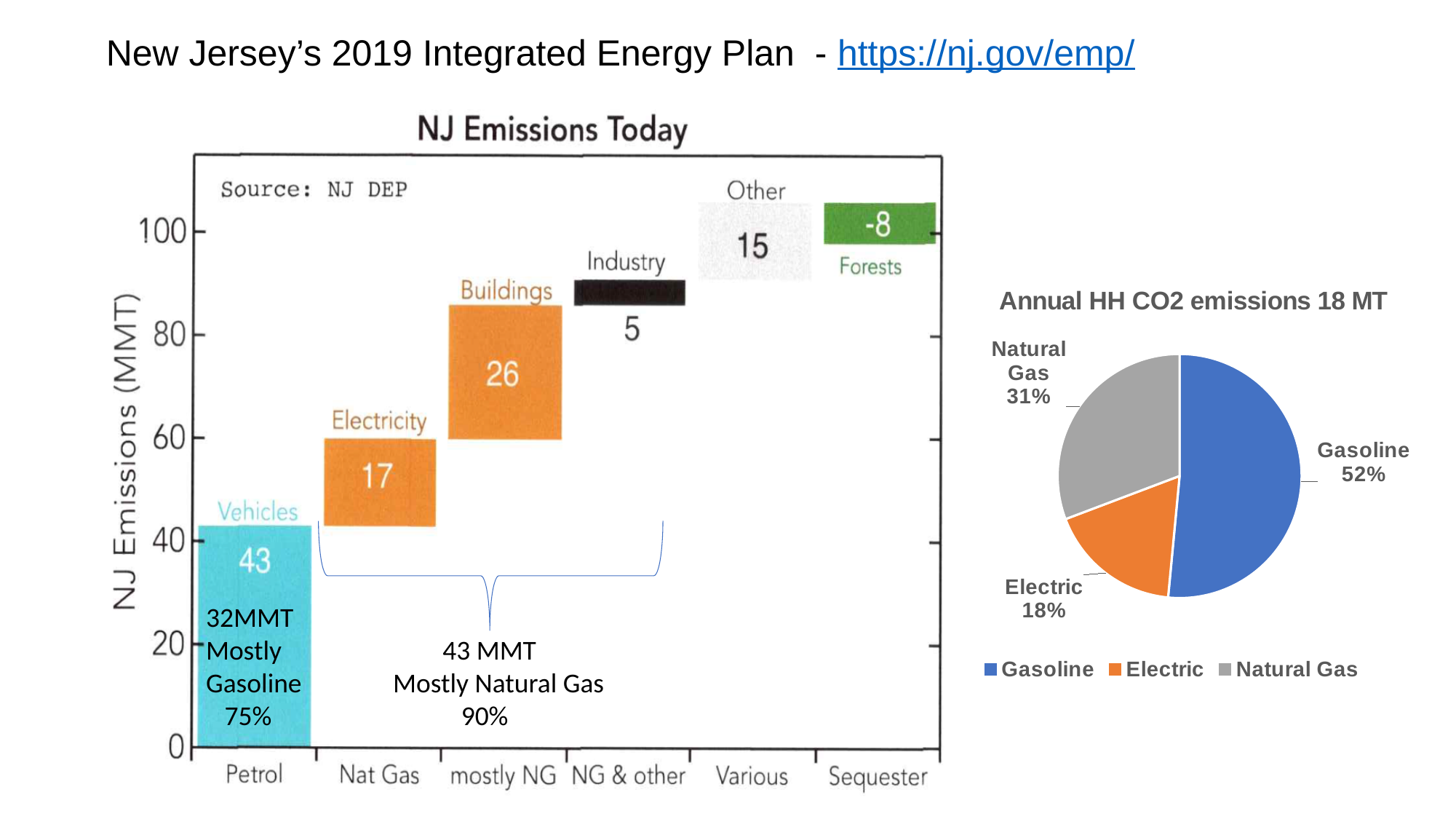
In the NJ Emissions Today chart, which is larger, the value for Other or the value for Industry? Other In the Annual HH CO2 emissions pie chart, what share does Gasoline have? 52% In the NJ Emissions Today chart, which category has the highest emissions value? Vehicles In the Annual HH CO2 emissions pie chart, what is the percentage for Electric? 18% In the NJ Emissions Today chart, what is the difference between the Buildings value and the Electricity value? 9 In the NJ Emissions Today chart, what is the value for Vehicles? 43 In the NJ Emissions Today chart, what is the value for Forests? -8 In the Annual HH CO2 emissions pie chart, which slice is the smallest? Electric What type of chart is the Annual HH CO2 emissions chart on the right? Pie chart In the NJ Emissions Today chart, how many categories are shown along the x axis? 6 In the NJ Emissions Today chart, which category has the lowest value? Forests In the NJ Emissions Today chart, what is the value for Buildings? 26